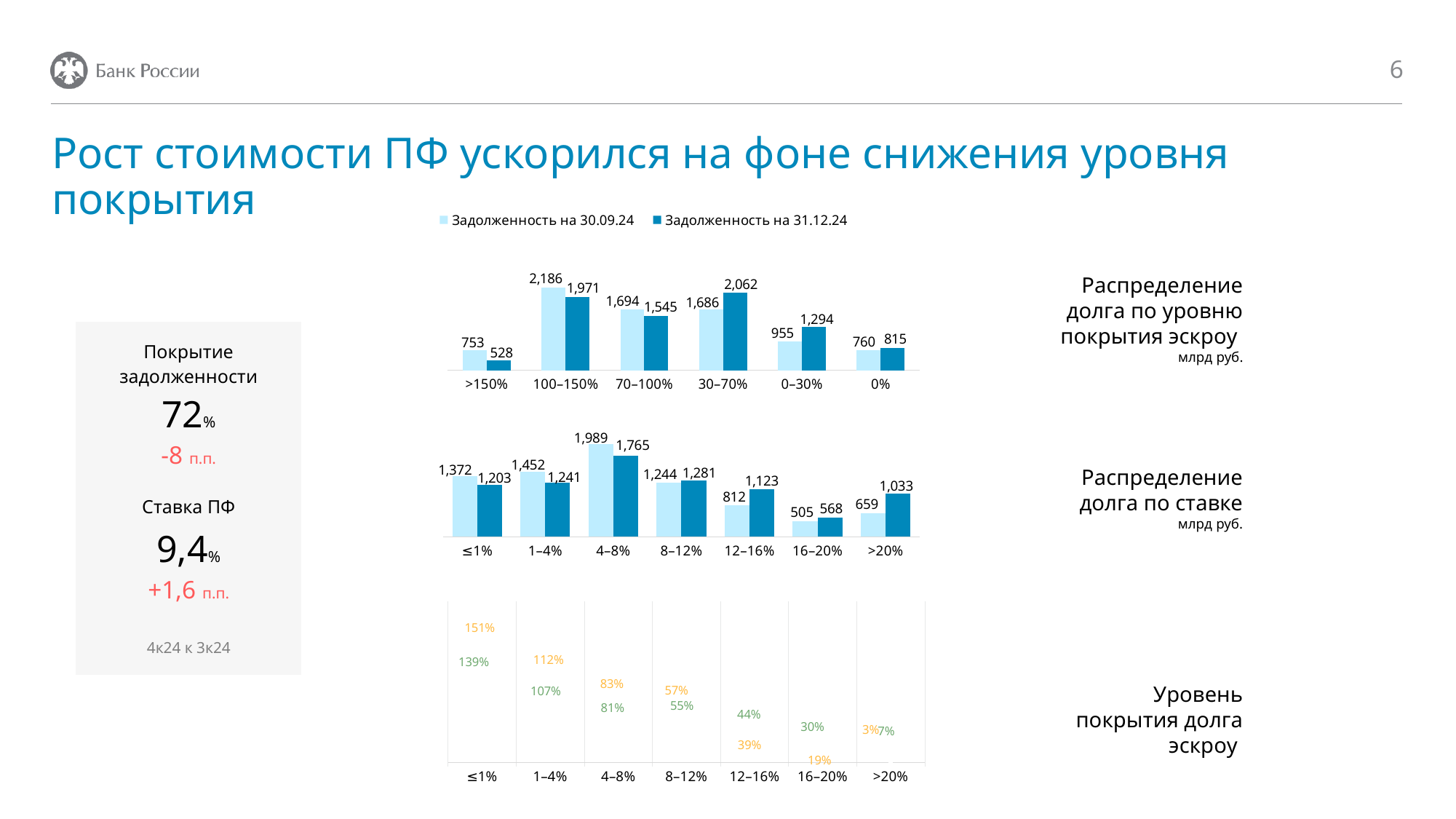
In the chart 'Распределение долга по уровню покрытия эскроу', what is the value for the 100–150% category for Задолженность на 30.09.24? 2,186 How many series does the legend list for the chart 'Распределение долга по уровню покрытия эскроу'? 2 In the chart 'Распределение долга по уровню покрытия эскроу', which category has the lowest value for Задолженность на 30.09.24? >150% What kind of chart is 'Распределение долга по ставке'? Bar chart In the chart 'Распределение долга по уровню покрытия эскроу', which category has the highest value for Задолженность на 31.12.24? 30–70% In the chart 'Распределение долга по ставке', what is the difference between the 31.12.24 and 30.09.24 values for the >20% category? 374 In the chart 'Распределение долга по уровню покрытия эскроу', what is the difference between the 31.12.24 and 30.09.24 values for the 30–70% category? 376 In the chart 'Распределение долга по уровню покрытия эскроу', what is the value for the 0–30% category for Задолженность на 31.12.24? 1,294 In the chart 'Распределение долга по ставке', which is larger for Задолженность на 31.12.24: the 8–12% category or the 12–16% category? 8–12% In the chart 'Распределение долга по ставке', what is the value for the 4–8% category for Задолженность на 31.12.24? 1,765 How many categories are shown on the x axis of the chart 'Распределение долга по уровню покрытия эскроу'? 6 In the chart 'Распределение долга по ставке', which category has the highest value for Задолженность на 30.09.24? 4–8%